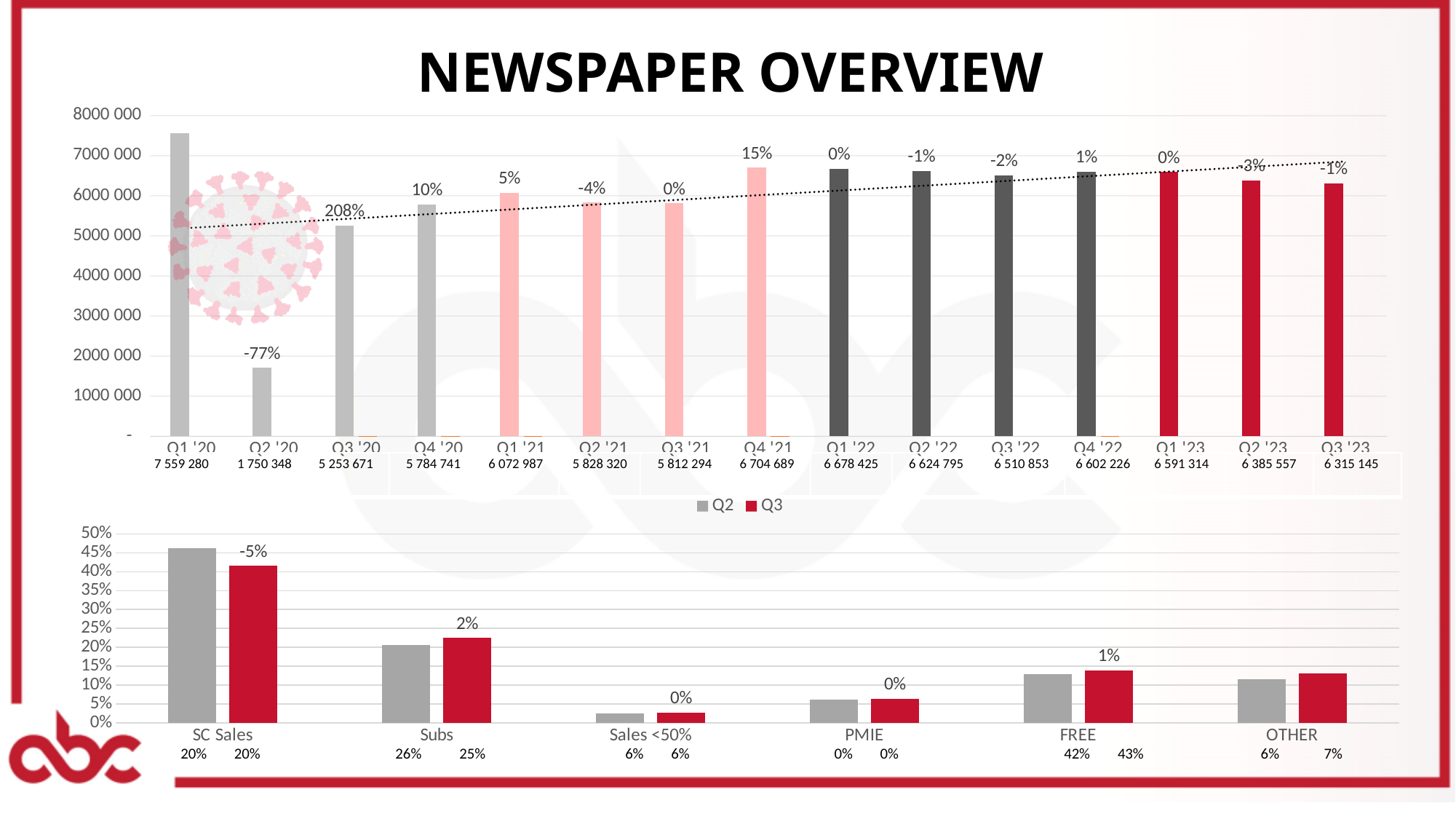
How many series does the legend of the bottom chart list? 2 In the top chart, what percentage change label is shown above the Q3 '20 bar? 208% In the top chart, what is the difference between the values for Q1 '20 and Q2 '20? 5 808 932 What kind of chart is the bottom chart? bar chart In the top chart, what is the value for Q1 '20? 7 559 280 In the top chart, which quarter has the highest value? Q1 '20 In the top chart, do the values rise or fall from Q1 '23 to Q3 '23? fall In the top chart, which is larger, the value for Q4 '21 or the value for Q1 '22? Q4 '21 In the top chart, what is the value for Q3 '23? 6 315 145 In the top chart, which quarter has the lowest value? Q2 '20 In the bottom chart, is the Q2 value for SC Sales greater or less than 40%? greater How many quarters are plotted in the top chart? 15